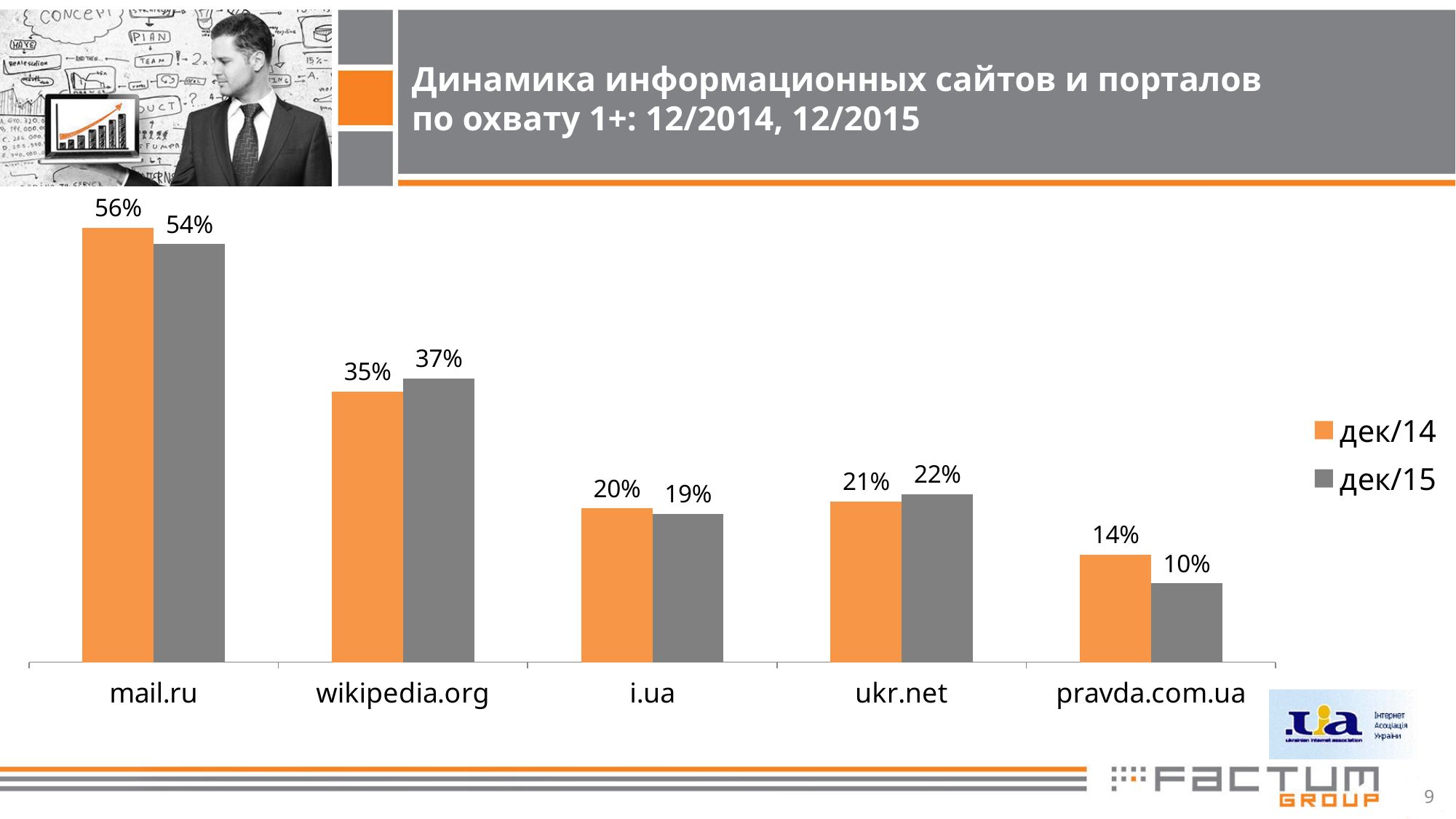
What is the value for pravda.com.ua in the дек/15 series? 10% Which is larger for wikipedia.org: the дек/14 value or the дек/15 value? дек/15 How many categories are shown on the x axis? 5 What is the value for wikipedia.org in the дек/15 series? 37% How many series does the legend list? 2 Which category has the highest value in the дек/14 series? mail.ru What kind of chart is shown on the slide? bar chart What is the difference between the дек/14 and дек/15 values for pravda.com.ua? 4% Which colour represents the дек/14 series? orange Which category has the lowest value in the дек/15 series? pravda.com.ua What is the difference between the дек/14 and дек/15 values for mail.ru? 2% What is the value for mail.ru in the дек/14 series? 56%